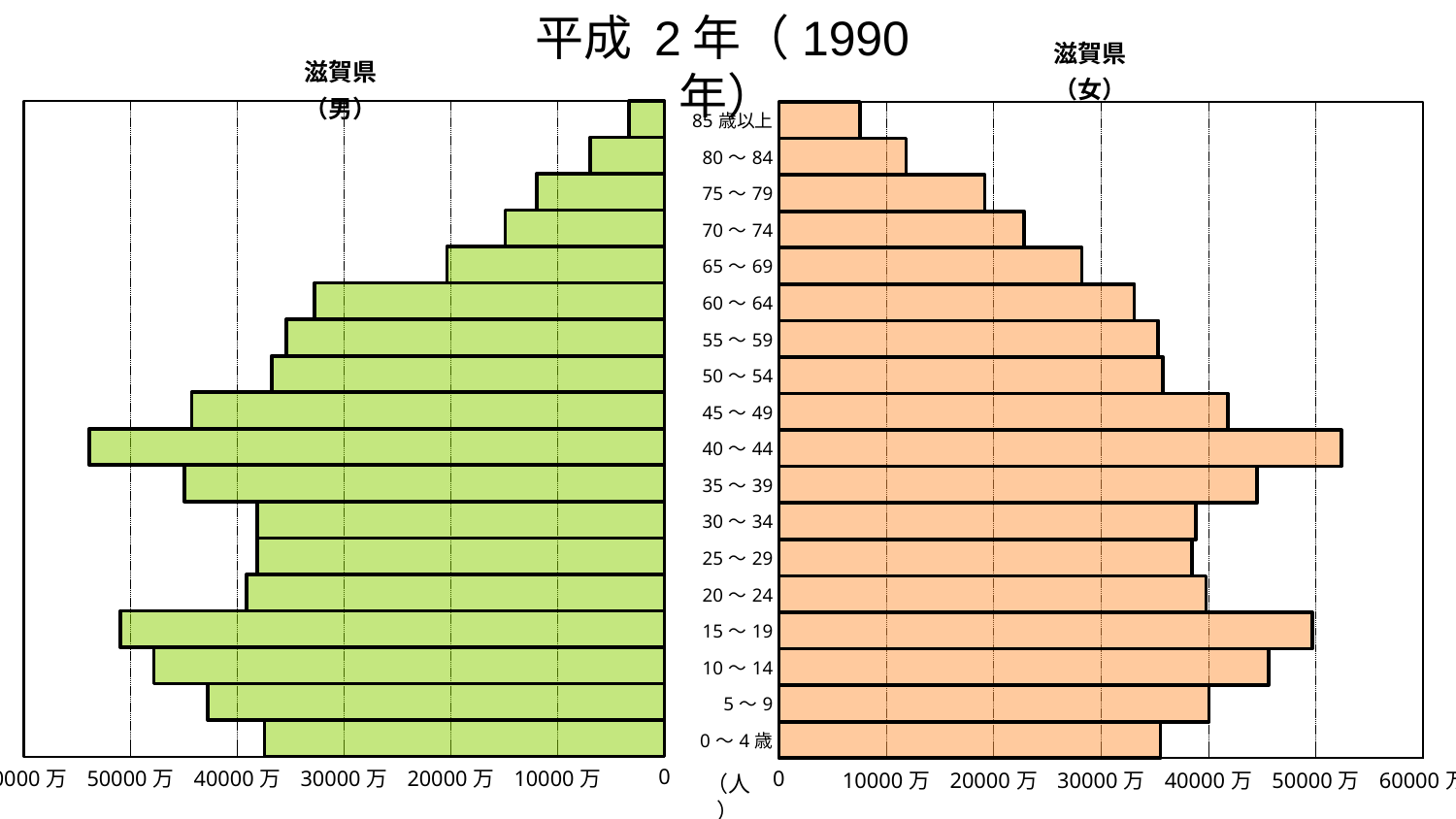
In the 滋賀県（女） chart, is the value for 85歳以上 greater or less than 10000万? less In the 滋賀県（女） chart, which age group has the longest bar? 40～44 In the 滋賀県（男） chart, is the value for 40～44 greater or less than 50000万? greater What kind of chart is shown on the slide? bar chart In the 滋賀県（女） chart, which age group has the shortest bar? 85歳以上 In the 滋賀県（男） chart, is the value for 60～64 greater or less than 30000万? greater In the 滋賀県（女） chart, which is larger, the value for 35～39 or the value for 30～34? 35～39 In the 滋賀県（男） chart, which age group has the longest bar? 40～44 How many age groups are plotted in the 滋賀県（男） chart? 18 In the 滋賀県（男） chart, which age group has the shortest bar? 85歳以上